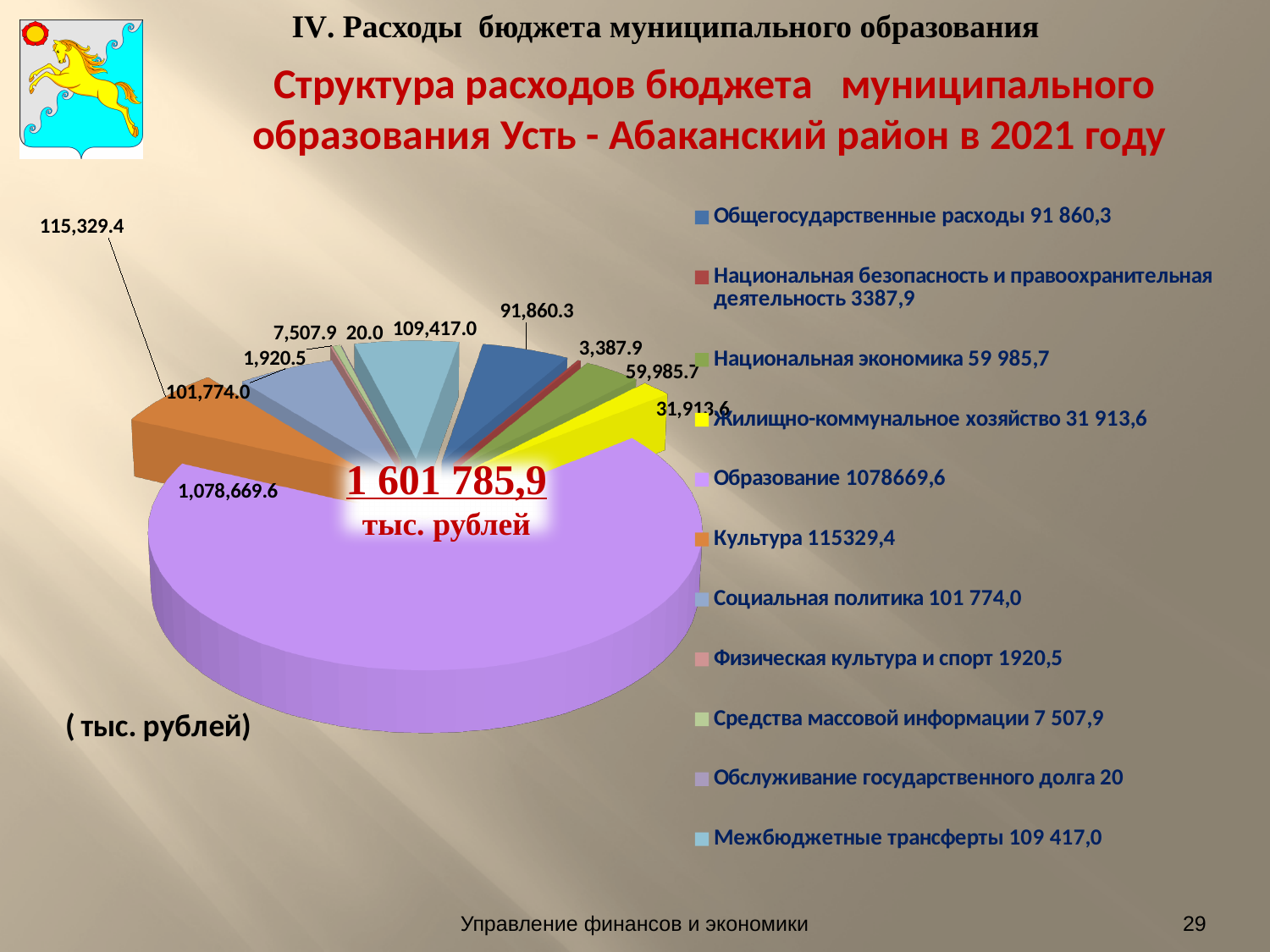
Which is larger: Общегосударственные расходы or Национальная экономика? Общегосударственные расходы What total value is printed in the centre of the pie chart? 1 601 785,9 тыс. рублей How many categories does the pie chart have? 11 What is the difference between the values for Культура and Социальная политика? 13,555.4 Which category has the smallest value in the pie chart? Обслуживание государственного долга What is the value for Межбюджетные трансферты in the pie chart? 109,417.0 Which category has the largest slice in the pie chart? Образование What colour is the Образование slice in the pie chart? purple What is the value for Культура in the pie chart? 115,329.4 What kind of chart is shown on the slide? pie chart What is the value for Образование in the pie chart? 1,078,669.6 What is the value for Обслуживание государственного долга in the pie chart? 20.0